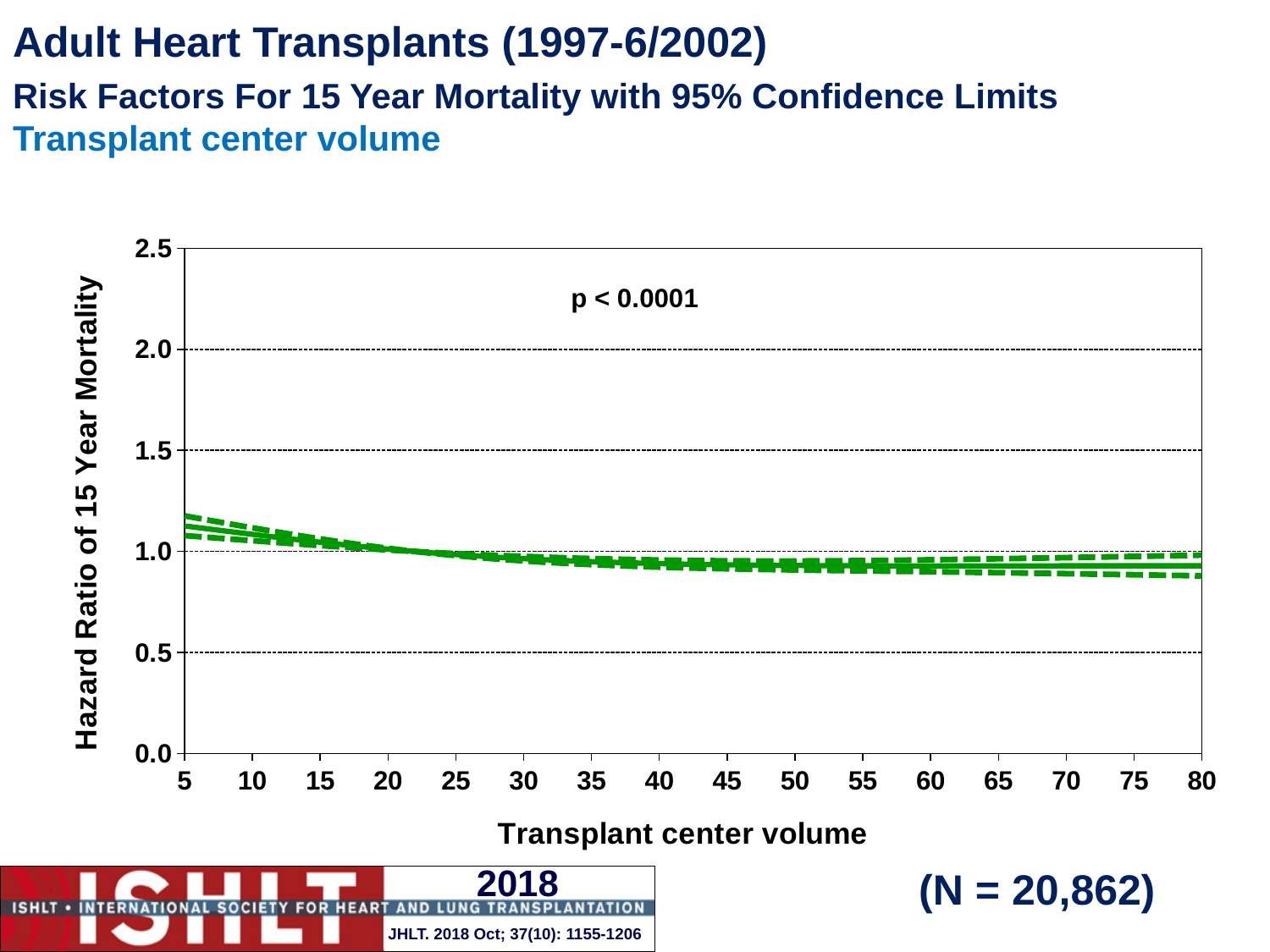
How many tick labels are shown on the x axis (Transplant center volume)? 16 Is the hazard ratio (solid line) at a transplant center volume of 50 greater or less than 1.0? less Is the hazard ratio (solid line) at a transplant center volume of 5 greater or less than 1.0? greater Is the hazard ratio at a transplant center volume of 5 larger or smaller than at a volume of 50? larger What sample size (N) is printed on the slide? N = 20,862 Is the upper 95% confidence limit at a transplant center volume of 40 greater or less than 1.5? less What p-value is printed on the chart? p < 0.0001 How many tick labels are shown on the y axis (Hazard Ratio of 15 Year Mortality)? 6 Does the hazard ratio rise or fall as transplant center volume increases from 5 to 50? fall What kind of chart is shown on the slide? line chart